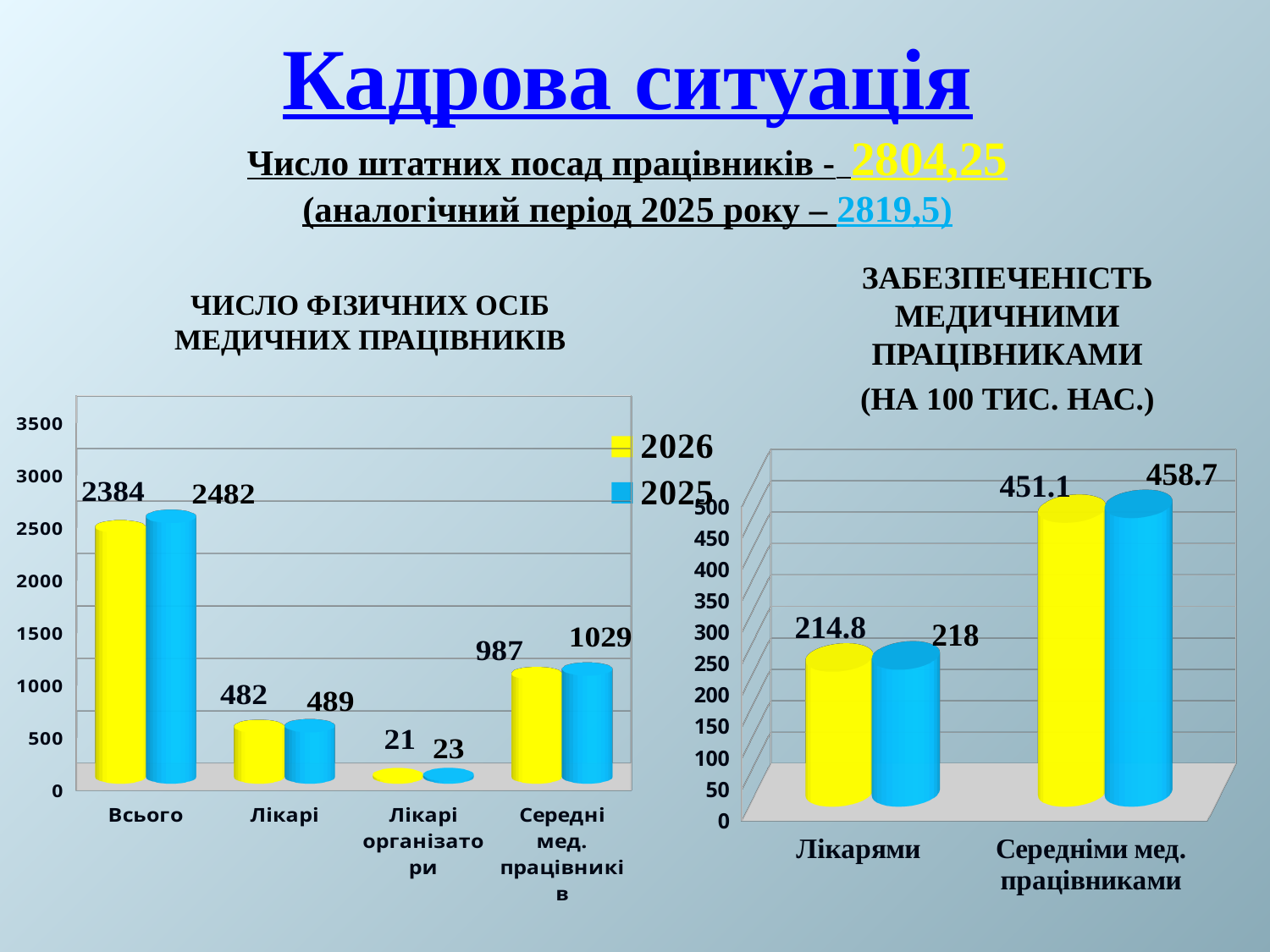
What type of chart is the right chart? Bar chart In the left chart, what is the value for Середні мед. працівники in the 2025 series? 1029 In the left chart, which category has the highest values? Всього In the left chart, what is the difference between the 2025 and 2026 values for Лікарі? 7 How many series does the legend of the left chart list? 2 In the left chart (ЧИСЛО ФІЗИЧНИХ ОСІБ МЕДИЧНИХ ПРАЦІВНИКІВ), what is the value for Всього in the 2026 series? 2384 In the left chart, which category has the lowest values? Лікарі організатори How many categories are shown on the x axis of the left chart? 4 In the left chart, what is the value for Лікарі організатори in the 2026 series? 21 In the left chart, which is larger for Всього: the 2026 value or the 2025 value? 2025 In the right chart (ЗАБЕЗПЕЧЕНІСТЬ МЕДИЧНИМИ ПРАЦІВНИКАМИ), what is the value of the yellow bar for Лікарями? 214.8 In the right chart, what is the value of the blue bar for Середніми мед. працівниками? 458.7